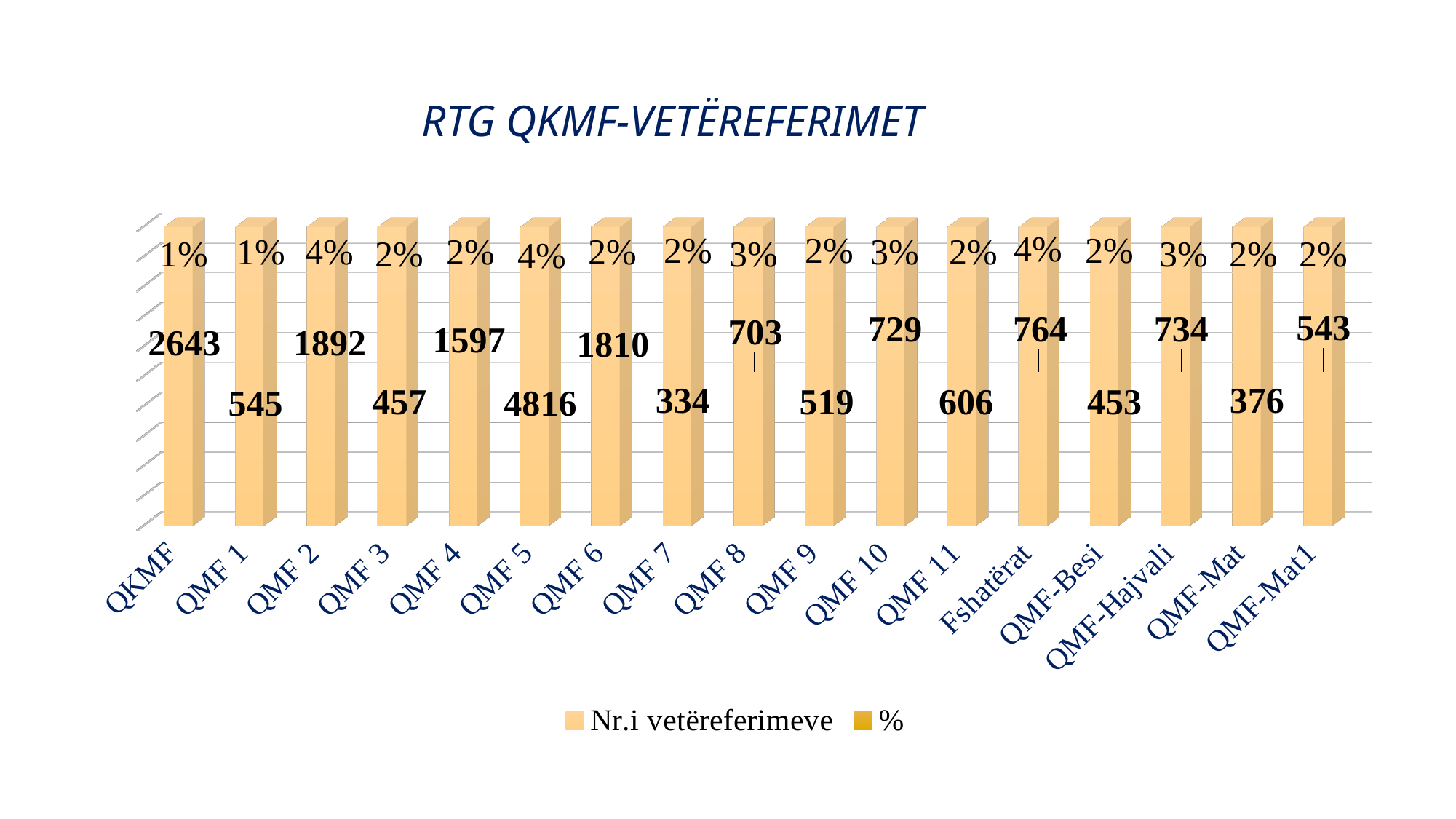
Which has a larger Nr.i vetëreferimeve value, QMF 2 or QMF 6? QMF 2 What is the title of the chart? RTG QKMF-VETËREFERIMET What is the value of Nr.i vetëreferimeve for QMF 5? 4816 What is the difference between the Nr.i vetëreferimeve values for QKMF and QMF 1? 2098 How many categories are shown on the x axis? 17 Which category has the highest Nr.i vetëreferimeve value? QMF 5 How many series does the legend list? 2 What is the value of Nr.i vetëreferimeve for QMF-Hajvali? 734 What kind of chart is shown on the slide? Bar chart What percentage is shown for Fshatërat? 4% What is the value of Nr.i vetëreferimeve for QKMF? 2643 Which category has the lowest Nr.i vetëreferimeve value? QMF 7